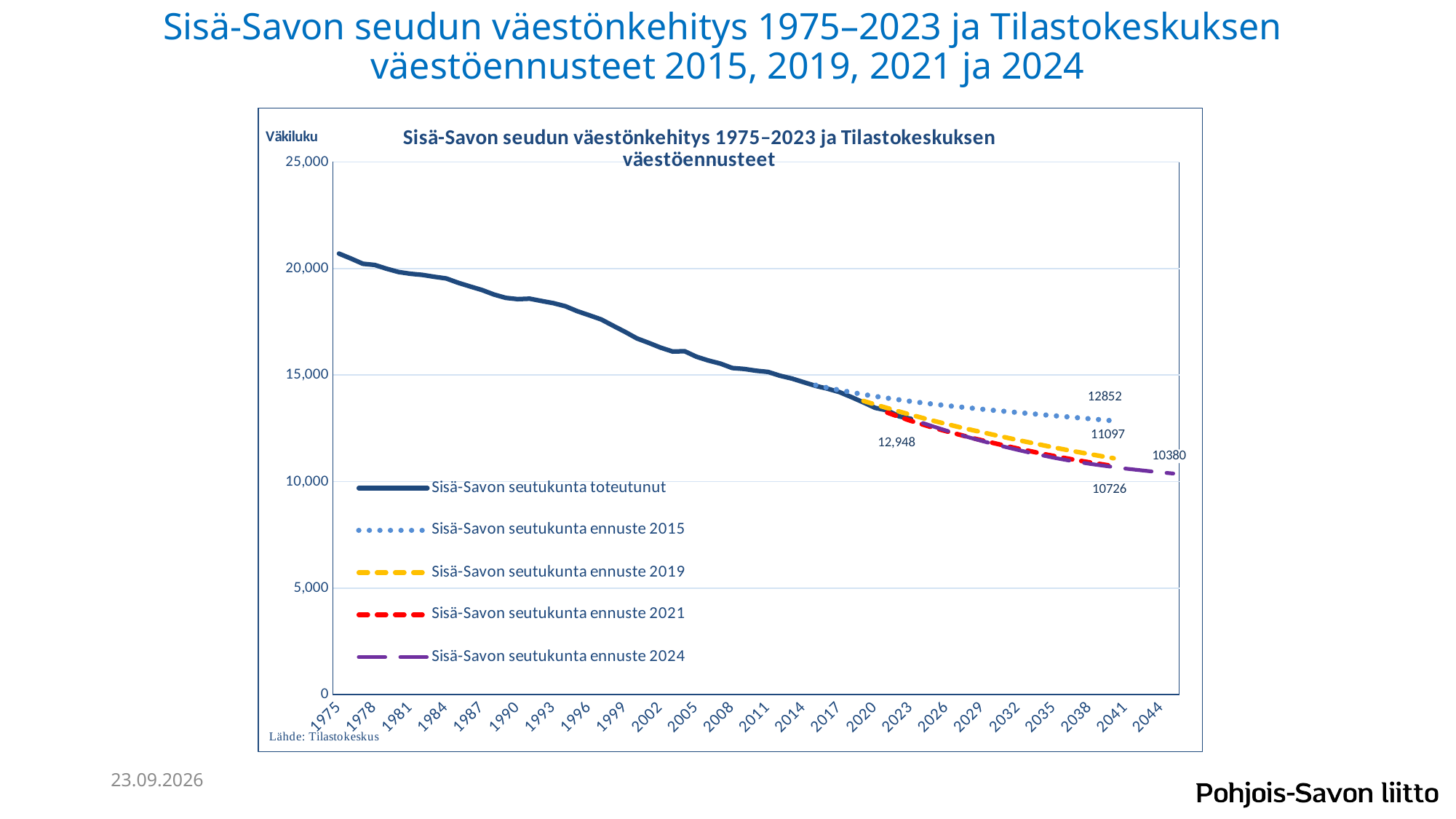
What kind of chart is shown on the slide? line chart What is the final labelled value of the Sisä-Savon seutukunta ennuste 2021 series? 10726 What is the final labelled value of the Sisä-Savon seutukunta ennuste 2015 series? 12852 What is the difference between the final labelled values of the ennuste 2015 series (12852) and the ennuste 2024 series (10380)? 2472 What is the labelled value at the end of the Sisä-Savon seutukunta toteutunut series? 12,948 Which forecast series ends at the lowest labelled value? Sisä-Savon seutukunta ennuste 2024 How many series does the legend list? 5 Is the value of the Sisä-Savon seutukunta toteutunut series in 1975 greater or less than 20,000? greater Which forecast series ends at the highest labelled value? Sisä-Savon seutukunta ennuste 2015 What is the final labelled value of the Sisä-Savon seutukunta ennuste 2024 series? 10380 Does the Sisä-Savon seutukunta toteutunut series rise or fall from 1975 to 2023? fall What is the final labelled value of the Sisä-Savon seutukunta ennuste 2019 series? 11097